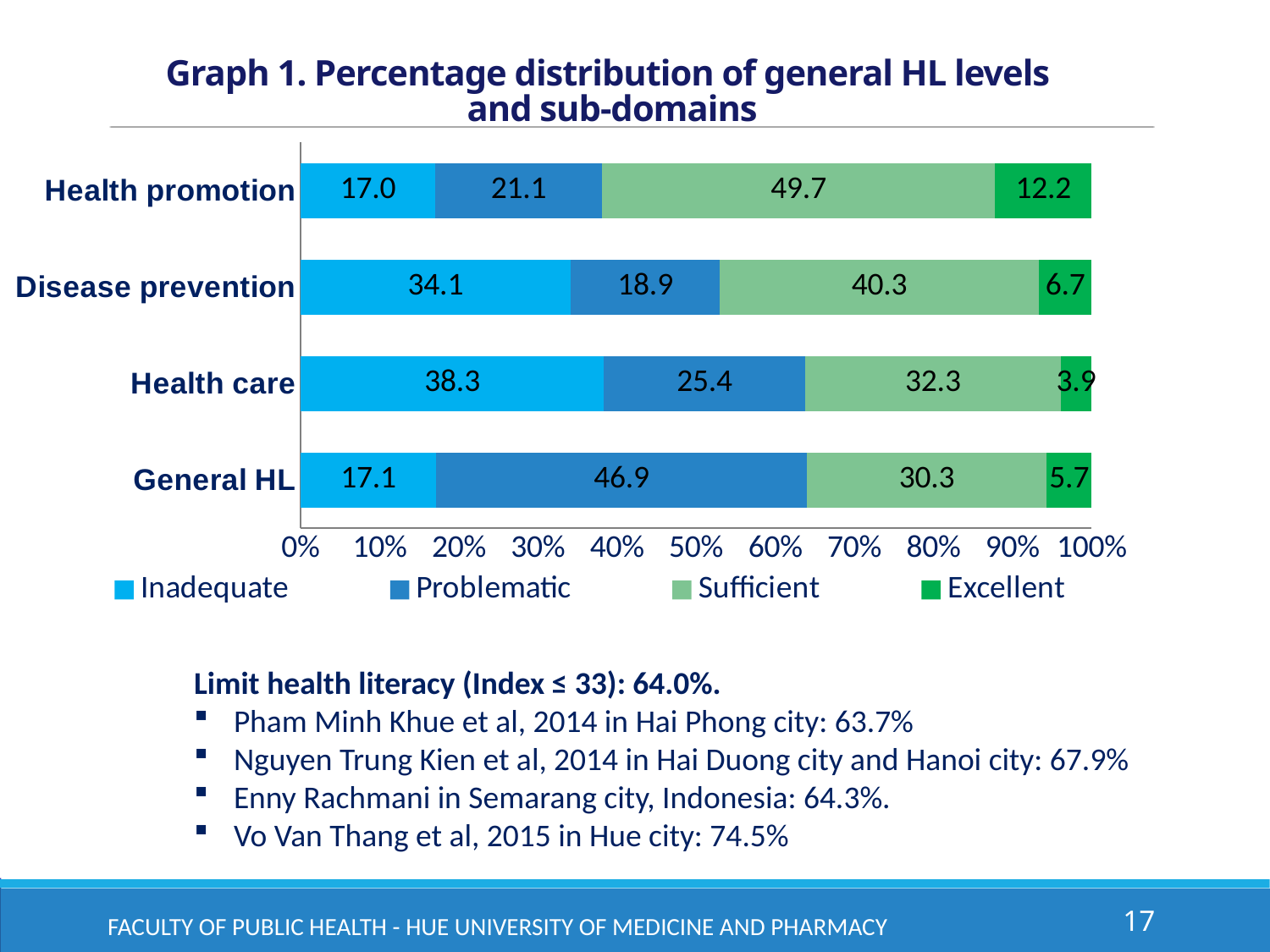
What is the title of the chart? Graph 1. Percentage distribution of general HL levels and sub-domains Which category has the lowest Inadequate value? Health promotion What is the Inadequate value for Health care? 38.3 Which category has the highest Excellent value? Health promotion What kind of chart is shown? Stacked bar chart What is the Sufficient value for Health promotion? 49.7 Which is larger, the Sufficient value for Disease prevention or for Health care? Disease prevention What is the difference between the Inadequate values for Health care and Disease prevention? 4.2 How many categories are shown on the y axis? 4 How many series does the legend list? 4 What is the Problematic value for General HL? 46.9 What is the Excellent value for Disease prevention? 6.7